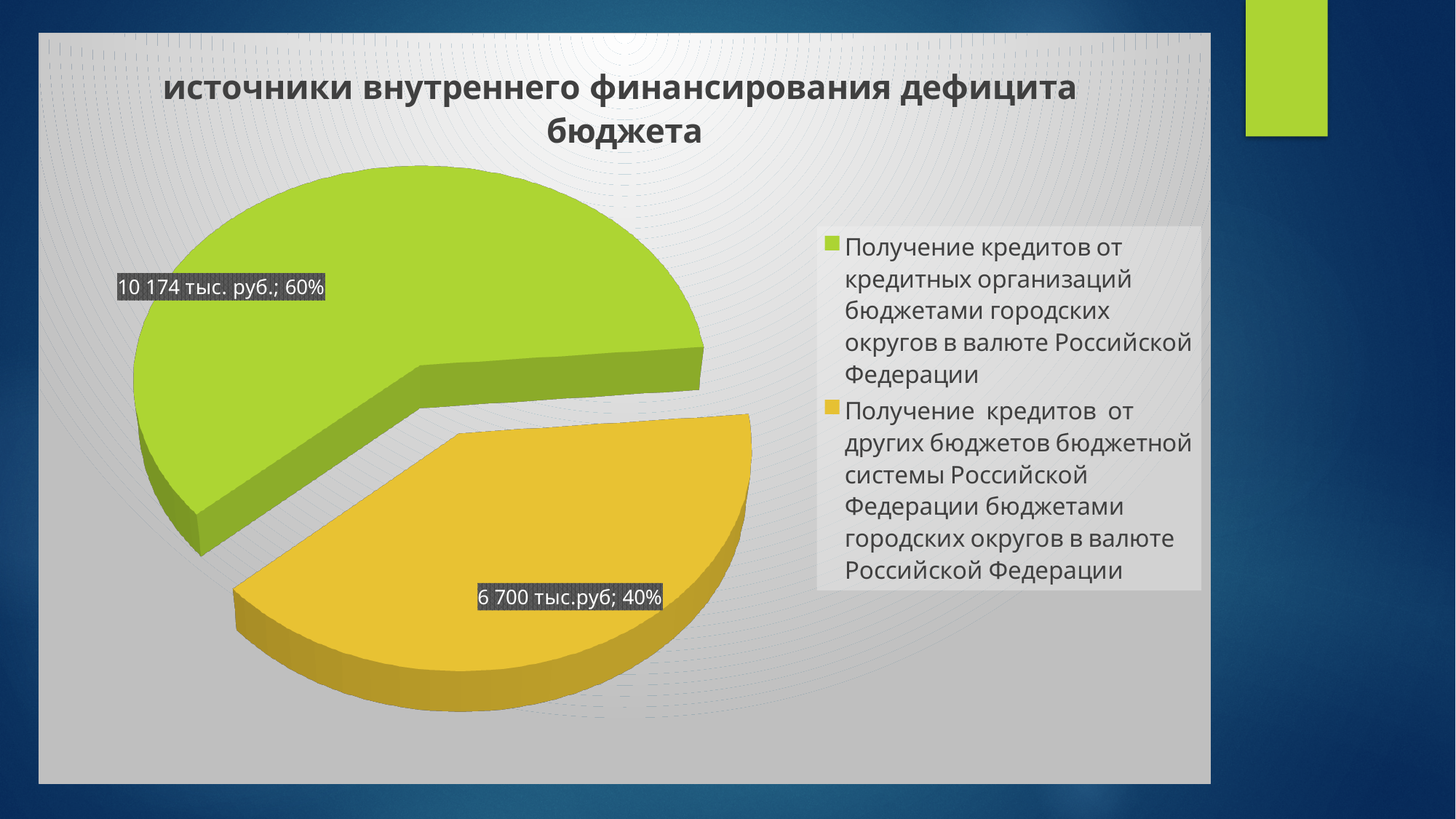
Which slice is the smallest? Получение кредитов от других бюджетов бюджетной системы Российской Федерации бюджетами городских округов в валюте Российской Федерации What share of the pie does the slice 'Получение кредитов от кредитных организаций бюджетами городских округов в валюте Российской Федерации' represent? 60% What value is shown for the slice 'Получение кредитов от других бюджетов бюджетной системы Российской Федерации бюджетами городских округов в валюте Российской Федерации'? 6 700 тыс.руб Which slice is the largest? Получение кредитов от кредитных организаций бюджетами городских округов в валюте Российской Федерации How many entries does the legend list? 2 What is the title of the chart? источники внутреннего финансирования дефицита бюджета Which is larger: the slice for credits from credit organisations (кредитных организаций) or the slice for credits from other budgets (других бюджетов)? credits from credit organisations (кредитных организаций) What colour is the slice for 'Получение кредитов от других бюджетов бюджетной системы Российской Федерации бюджетами городских округов в валюте Российской Федерации'? yellow What share of the pie does the slice 'Получение кредитов от других бюджетов бюджетной системы Российской Федерации бюджетами городских округов в валюте Российской Федерации' represent? 40% What value is shown for the slice 'Получение кредитов от кредитных организаций бюджетами городских округов в валюте Российской Федерации'? 10 174 тыс. руб. How many slices does the pie chart have? 2 What kind of chart is shown on the slide? pie chart